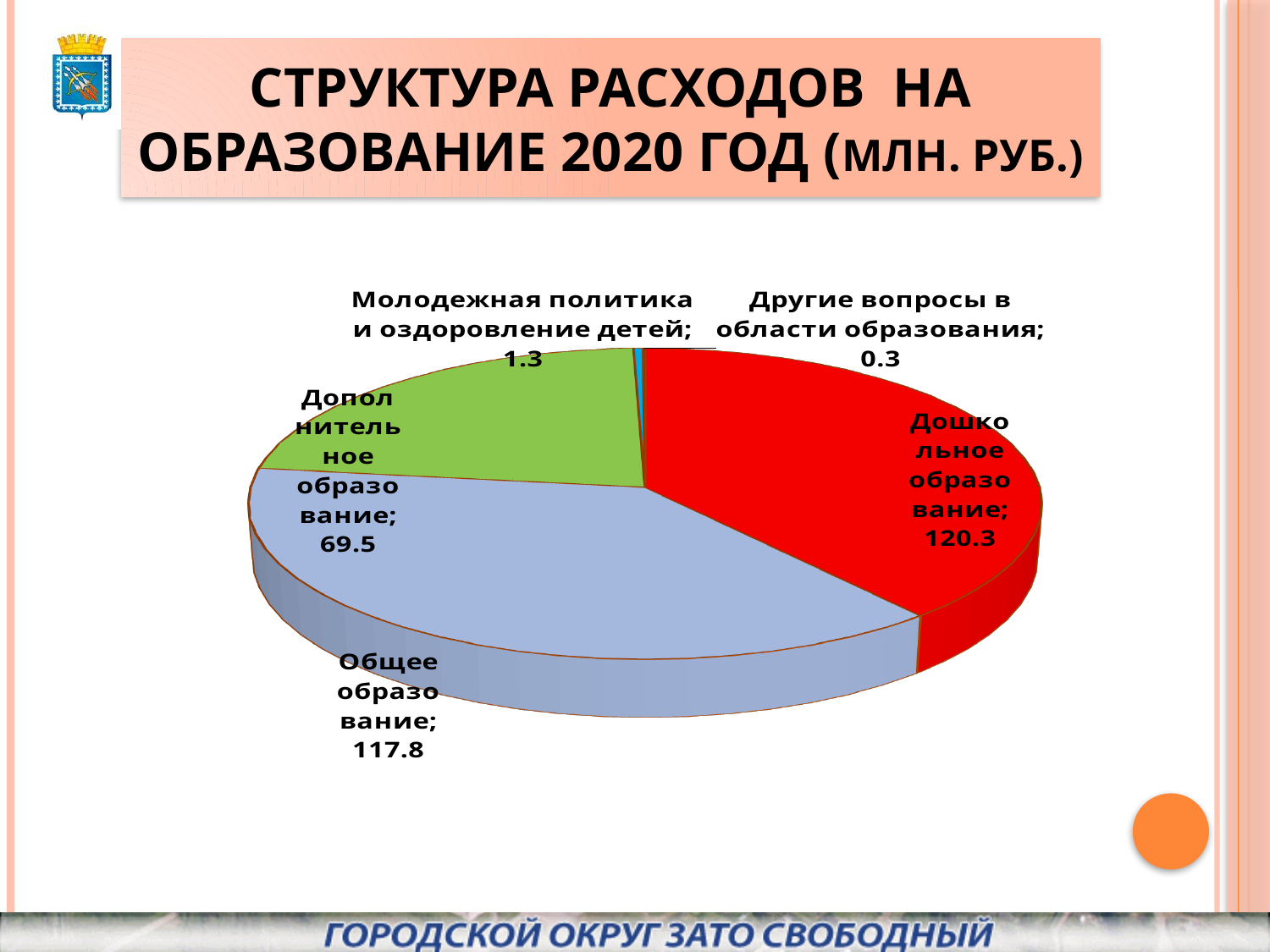
What is the value for Молодежная политика и оздоровление детей? 1.3 What is the difference between Дошкольное образование and Общее образование? 2.5 Which is larger: Общее образование or Дополнительное образование? Общее образование What is the value for Дополнительное образование? 69.5 Which category has the smallest value? Другие вопросы в области образования What kind of chart is shown on the slide? Pie chart What is the value for Дошкольное образование? 120.3 How many slices does the pie chart have? 5 Which category has the largest value? Дошкольное образование What is the value for Общее образование? 117.8 What is the value for Другие вопросы в области образования? 0.3 What is the total of all slices in the pie chart? 309.2